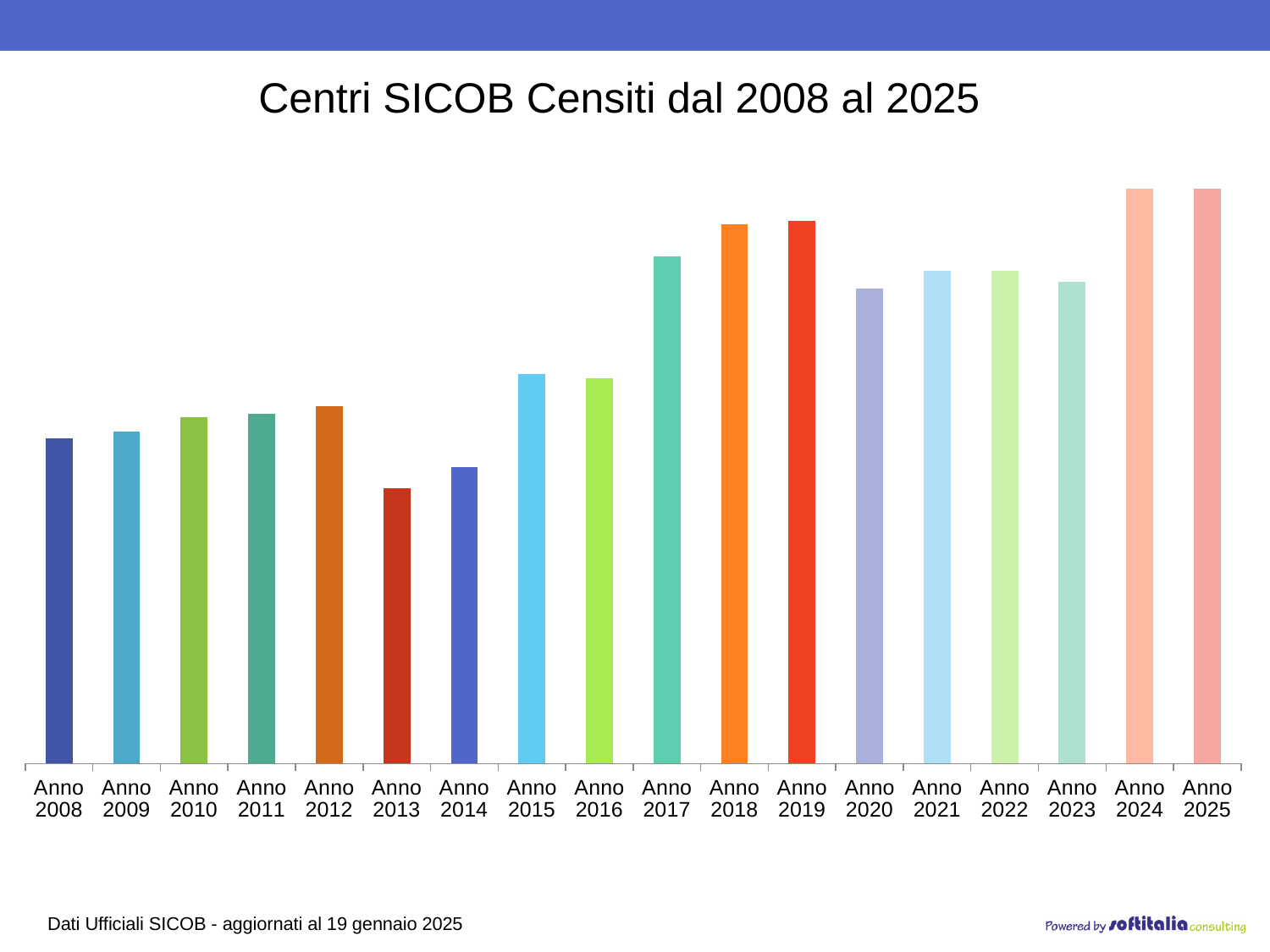
Which is larger, the value for Anno 2013 or the value for Anno 2014? Anno 2014 Which is larger, the value for Anno 2019 or the value for Anno 2020? Anno 2019 Which year has the lowest bar in the chart? Anno 2013 What kind of chart is shown on the slide? bar chart Which is larger, the value for Anno 2016 or the value for Anno 2021? Anno 2021 Do the values rise or fall from Anno 2008 to Anno 2012? rise What is the first year shown on the x axis of the chart? Anno 2008 Do the values rise or fall from Anno 2014 to Anno 2018? rise How many years (bars) are shown in the chart? 18 What is the title of the chart? Centri SICOB Censiti dal 2008 al 2025